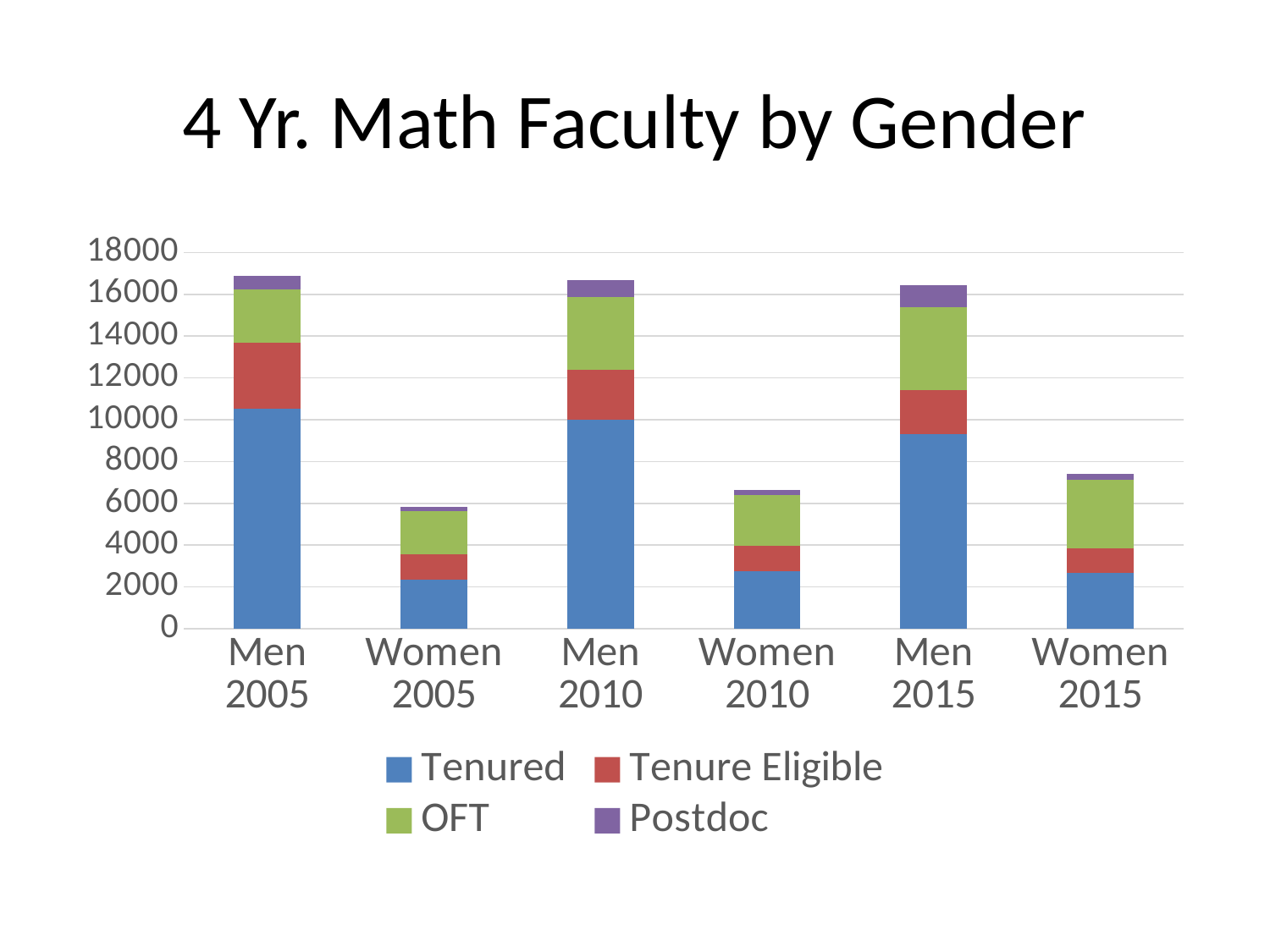
Is the Tenured value for Women 2005 greater or less than 2000? greater How many bars (categories) are shown on the x axis? 6 Which bar has the lowest total height? Women 2005 Which is larger, the Tenured value for Men 2005 or for Men 2015? Men 2005 What kind of chart is shown on the slide? Stacked bar chart How many series does the legend list? 4 Which is larger, the total for Women 2015 or the total for Women 2005? Women 2015 Is the Tenured value for Men 2015 greater or less than 10000? less Is the total height of the Men 2015 bar greater or less than 16000? greater What is the title of the chart? 4 Yr. Math Faculty by Gender Which series is shown in blue in the legend? Tenured